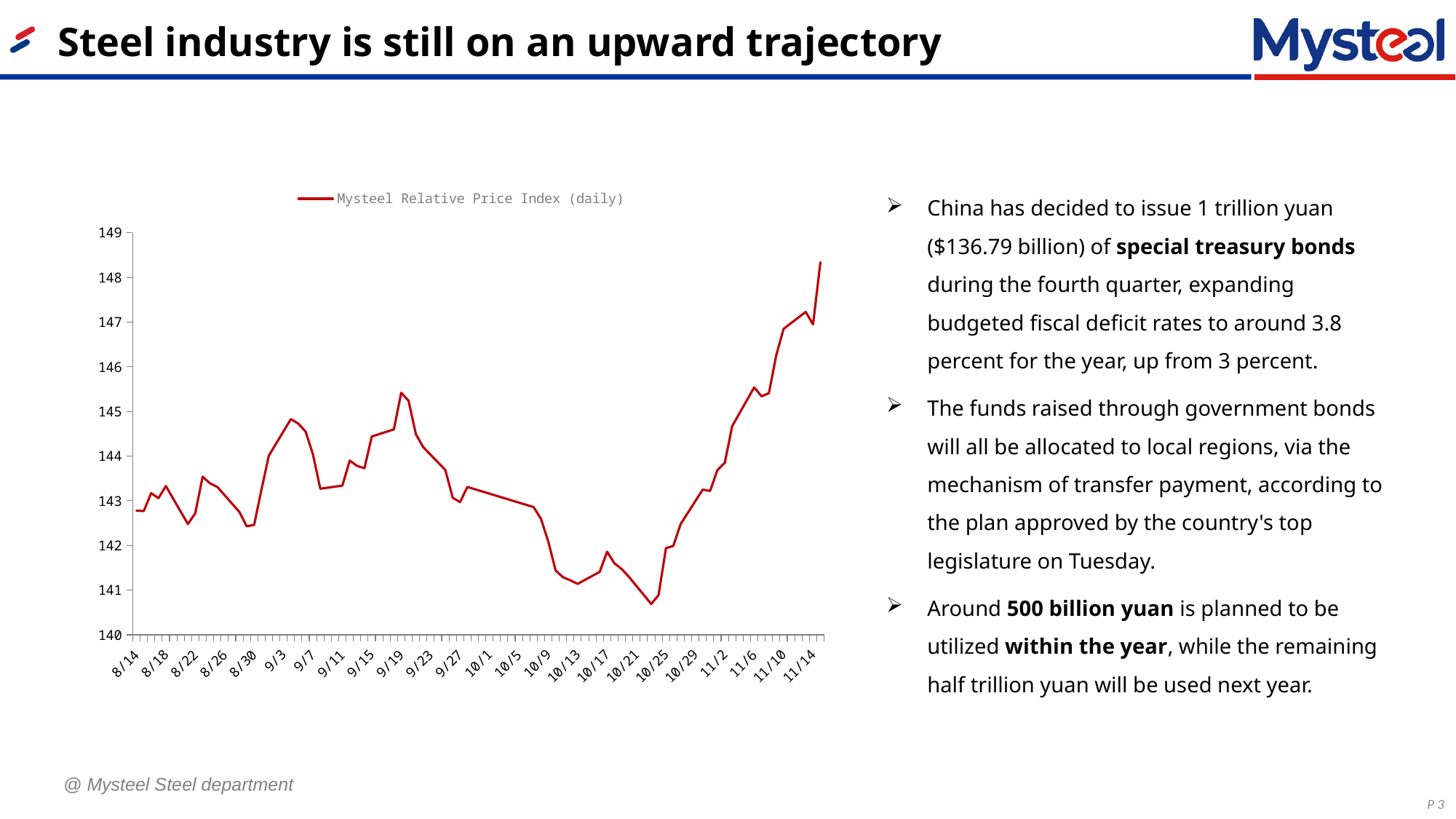
Is the value of the index on 9/19 greater or less than 145? greater How many series does the chart legend list? 1 What kind of chart is shown on the slide? Line chart What is the name of the series shown in the chart legend? Mysteel Relative Price Index (daily) How many date labels are shown on the x axis of the chart? 24 Is the value of the index on 8/30 greater or less than 143? less Is the value of the index on 11/10 greater or less than 146? greater Overall, does the Mysteel Relative Price Index rise or fall from 8/14 to the end of the series? Rise Which date has the higher index value, 9/19 or 10/13? 9/19 What colour is the line plotted in the chart? Red